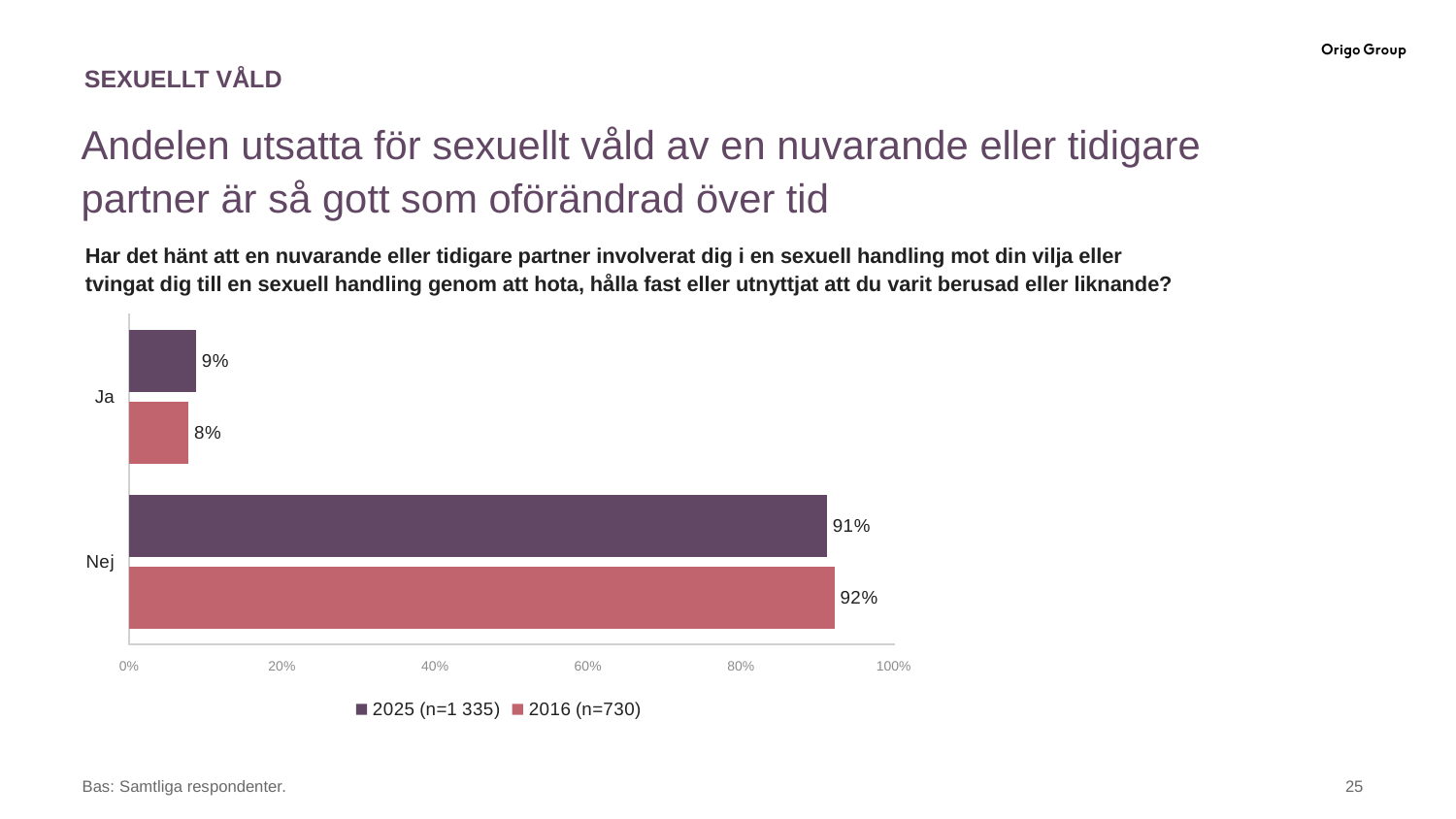
Which is larger for "Nej": the 2025 (n=1 335) value or the 2016 (n=730) value? 2016 (n=730) How many categories are shown on the chart? 2 What is the value for "Ja" in the 2025 (n=1 335) series? 9% What is the value for "Nej" in the 2025 (n=1 335) series? 91% What is the value for "Ja" in the 2016 (n=730) series? 8% What is the difference between the 2025 and 2016 values for "Ja"? 1% What kind of chart is shown on the slide? bar chart How many series does the legend list? 2 Which category has the highest value in the 2025 (n=1 335) series? Nej What is the value for "Nej" in the 2016 (n=730) series? 92% Is the 2025 value for "Nej" greater or less than 80%? greater Which category has the lowest value in the 2016 (n=730) series? Ja